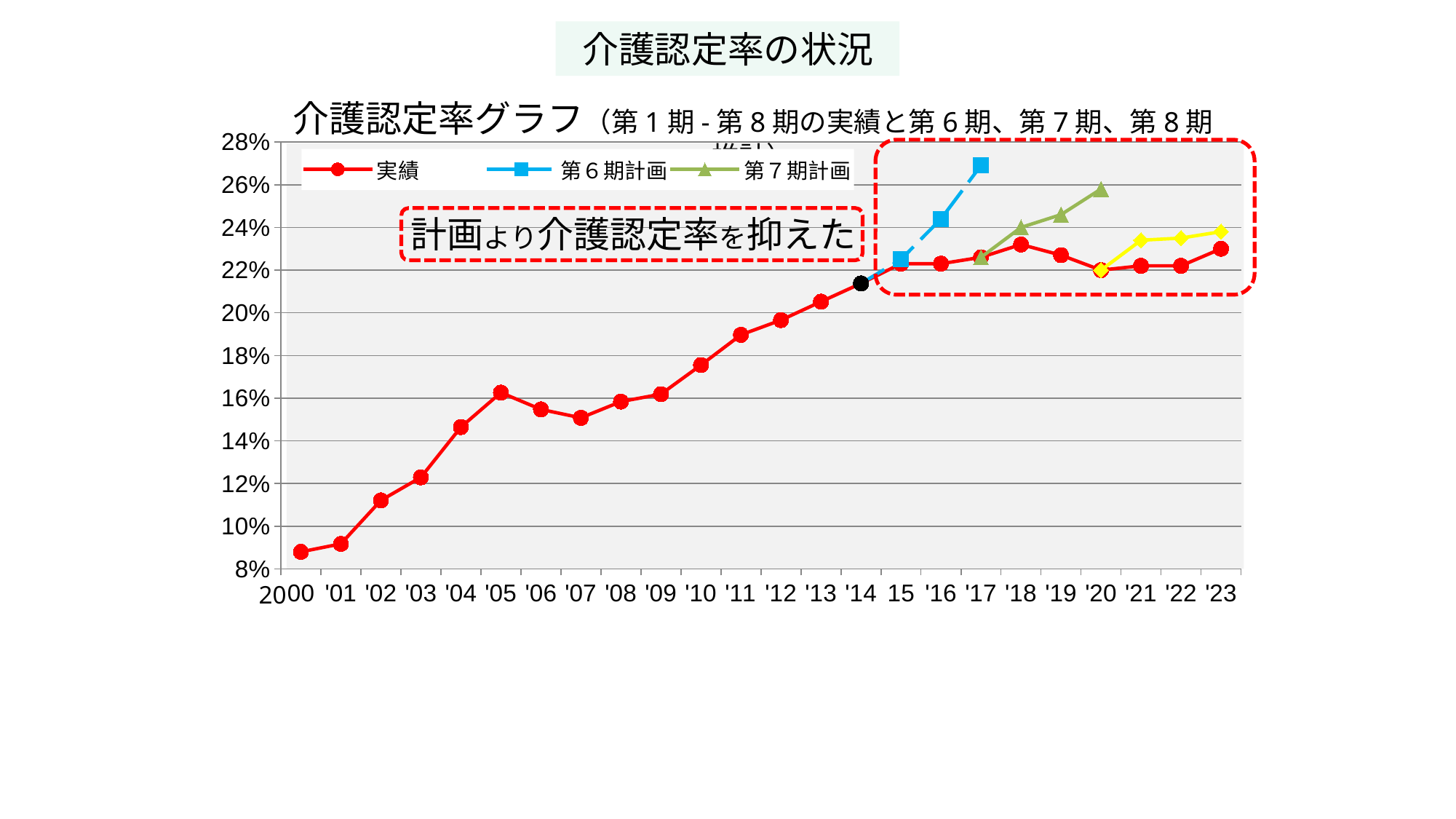
Is the value for 第６期計画 in '17 greater or less than 26%? greater Is the value for 実績 in 2000 greater or less than 10%? less What kind of chart is shown on the slide? line chart How many years are shown on the x axis? 24 Does the 実績 series rise or fall from 2000 to '05? rise How many series does the legend list? 3 What colour is the 実績 series line? red Is the value for 実績 in '14 greater or less than 20%? greater In which year is the 実績 series at its lowest? 2000 In '17, which is larger: 実績 or 第６期計画? 第６期計画